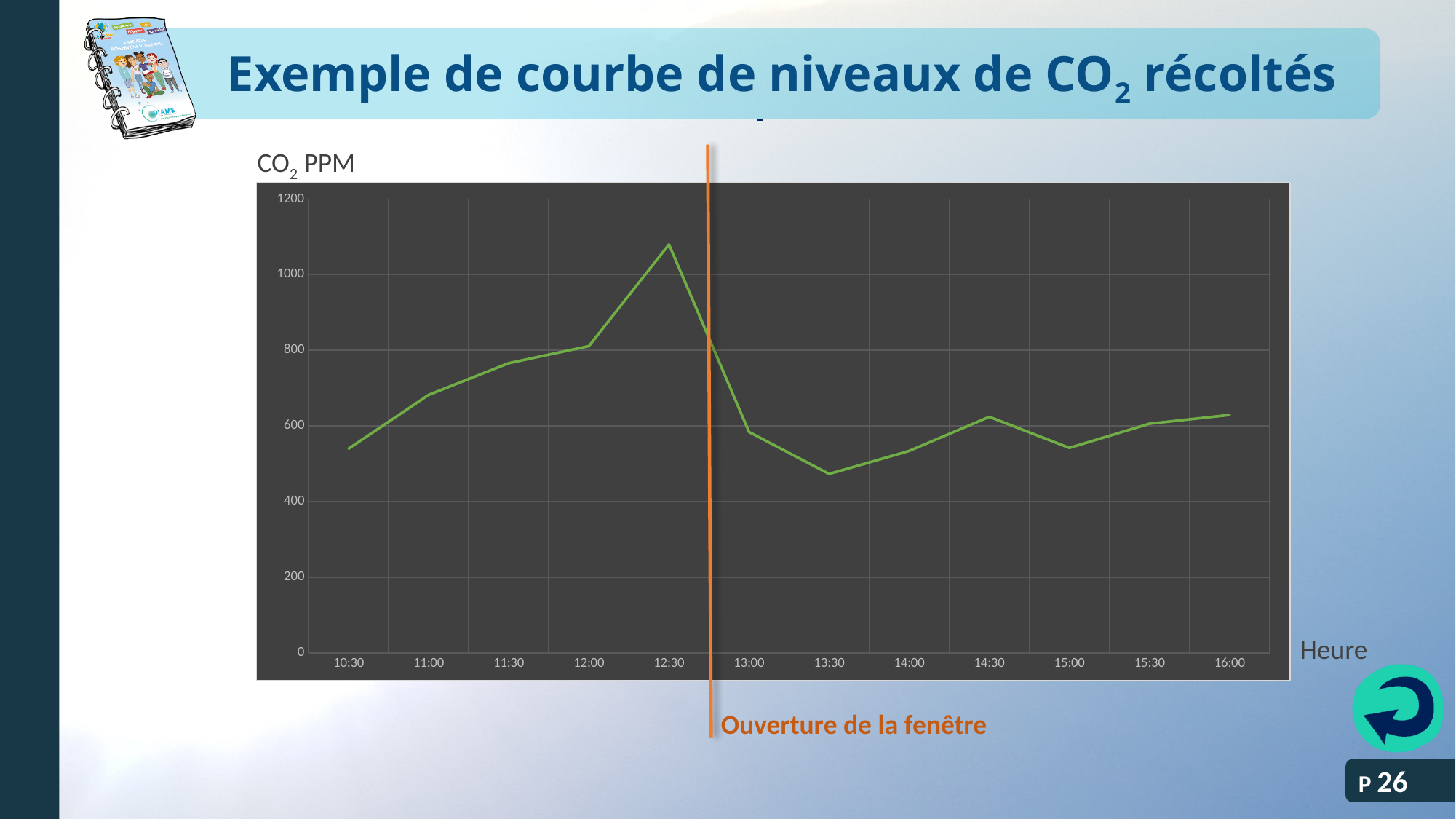
Is the CO2 value at 13:30 greater or less than 600? less At which time is the CO2 level highest? 12:30 Do the CO2 values rise or fall between 10:30 and 12:30? rise Is the CO2 value at 12:30 greater or less than 1000? greater Which time has a higher CO2 value, 12:00 or 13:00? 12:00 Is the CO2 value at 15:00 greater or less than 600? less What kind of chart is shown on the slide? line chart Which time has a higher CO2 value, 11:00 or 14:00? 11:00 How many time points are plotted along the x axis? 12 What event does the orange vertical line on the chart mark? Ouverture de la fenêtre At which time is the CO2 level lowest? 13:30